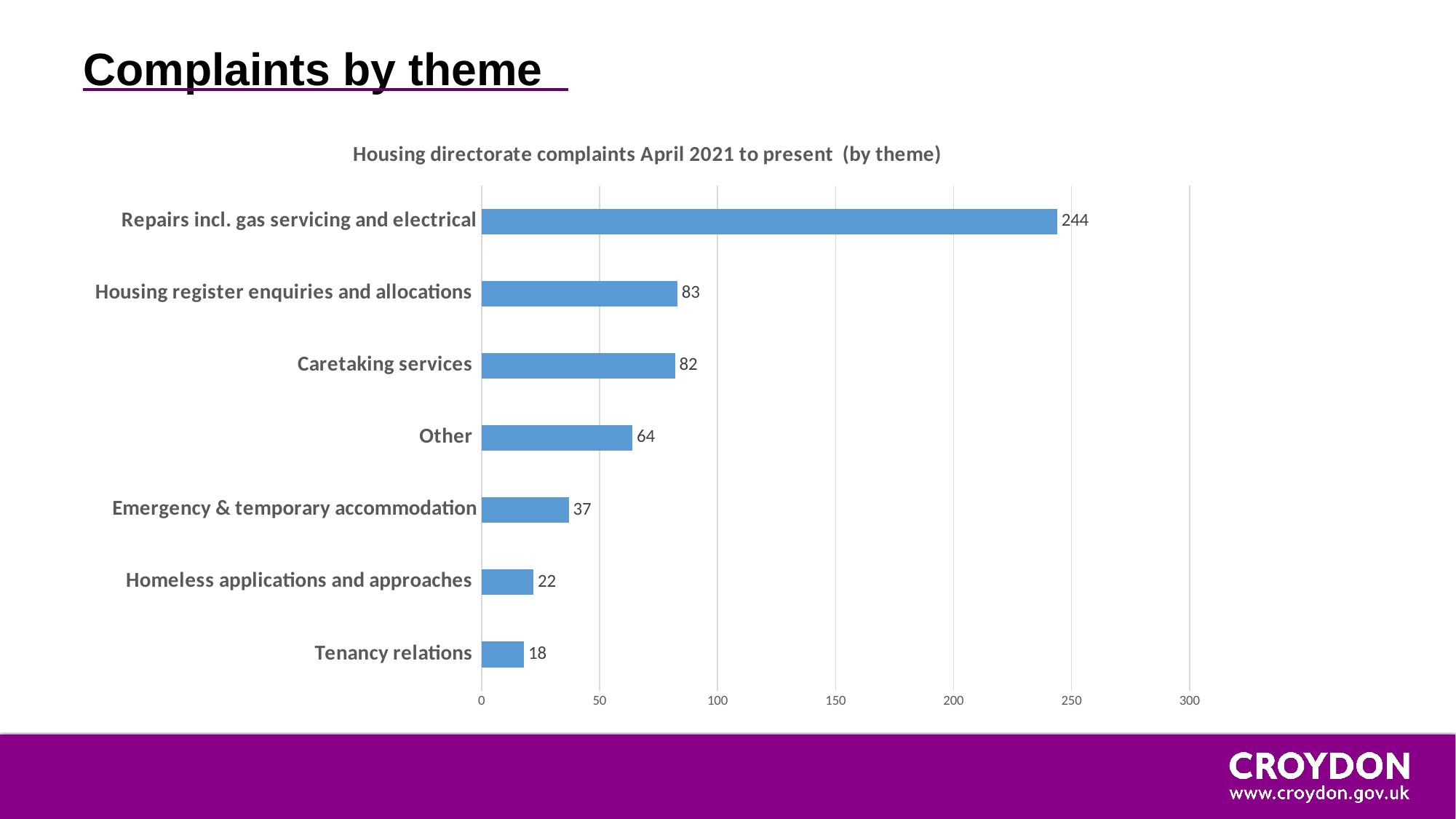
What is the value for Emergency & temporary accommodation? 37 Which is larger, the value for Other or the value for Emergency & temporary accommodation? Other What is the difference between the values for Other and Homeless applications and approaches? 42 Is the value for Repairs incl. gas servicing and electrical greater or less than 200? greater What is the value for Caretaking services? 82 Which theme has the lowest number of complaints? Tenancy relations How many themes are shown in the chart? 7 What is the difference between the values for Repairs incl. gas servicing and electrical and Housing register enquiries and allocations? 161 How many complaints are shown for Repairs incl. gas servicing and electrical? 244 Which theme has the highest number of complaints? Repairs incl. gas servicing and electrical What is the title of the chart? Housing directorate complaints April 2021 to present (by theme) What kind of chart is shown on the slide? Bar chart